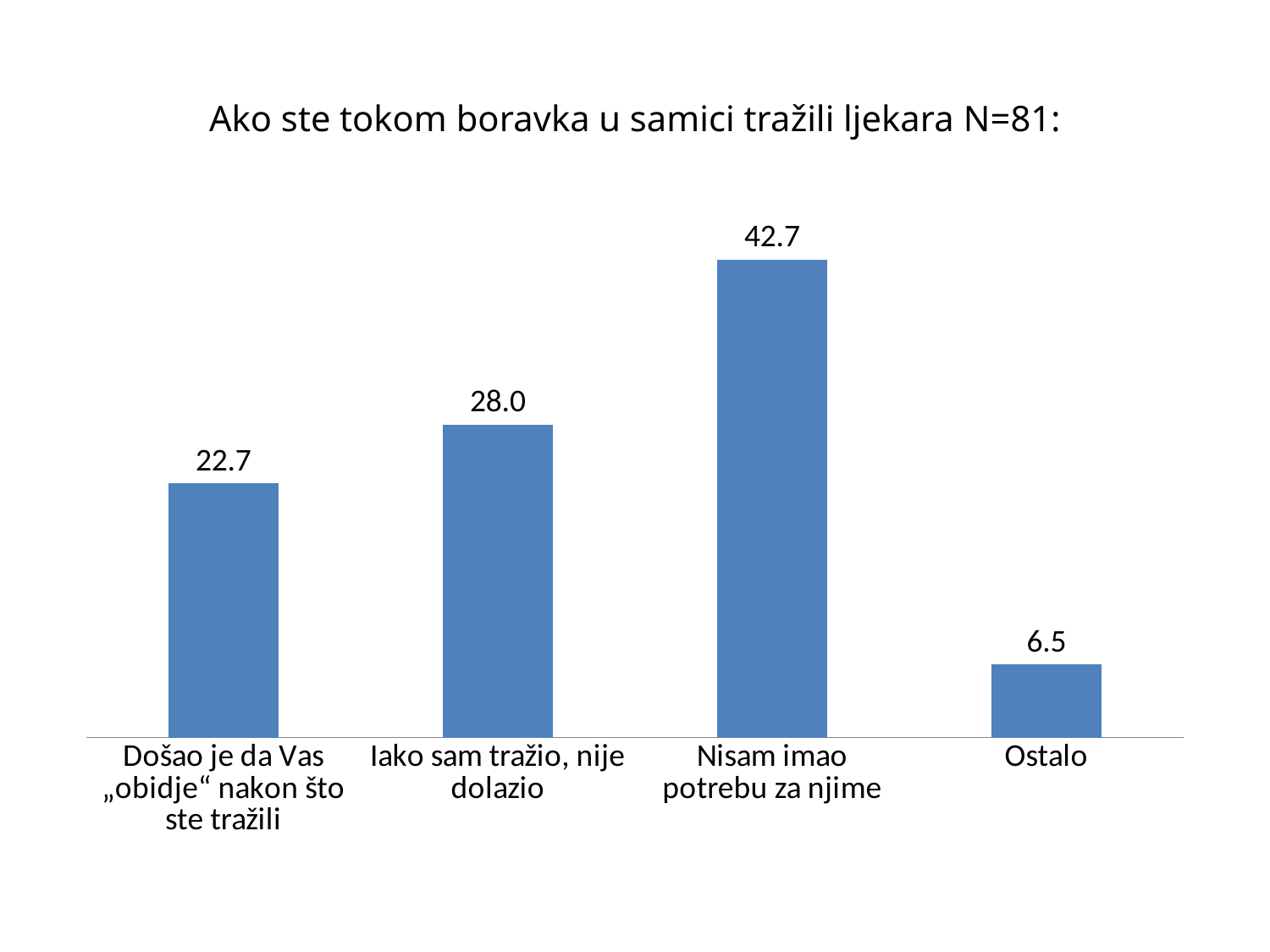
What is the title of the chart? Ako ste tokom boravka u samici tražili ljekara N=81: What is the value for "Došao je da Vas „obidje“ nakon što ste tražili"? 22.7 What is the difference between the values for "Iako sam tražio, nije dolazio" and "Došao je da Vas „obidje“ nakon što ste tražili"? 5.3 What is the difference between the values for "Nisam imao potrebu za njime" and "Iako sam tražio, nije dolazio"? 14.7 Which is larger: the value for "Iako sam tražio, nije dolazio" or the value for "Došao je da Vas „obidje“ nakon što ste tražili"? Iako sam tražio, nije dolazio What is the value for "Ostalo"? 6.5 What kind of chart is shown on the slide? Bar chart Which category has the highest value? Nisam imao potrebu za njime What is the value for "Nisam imao potrebu za njime"? 42.7 Which category has the lowest value? Ostalo How many categories are shown in the chart? 4 What is the value for "Iako sam tražio, nije dolazio"? 28.0